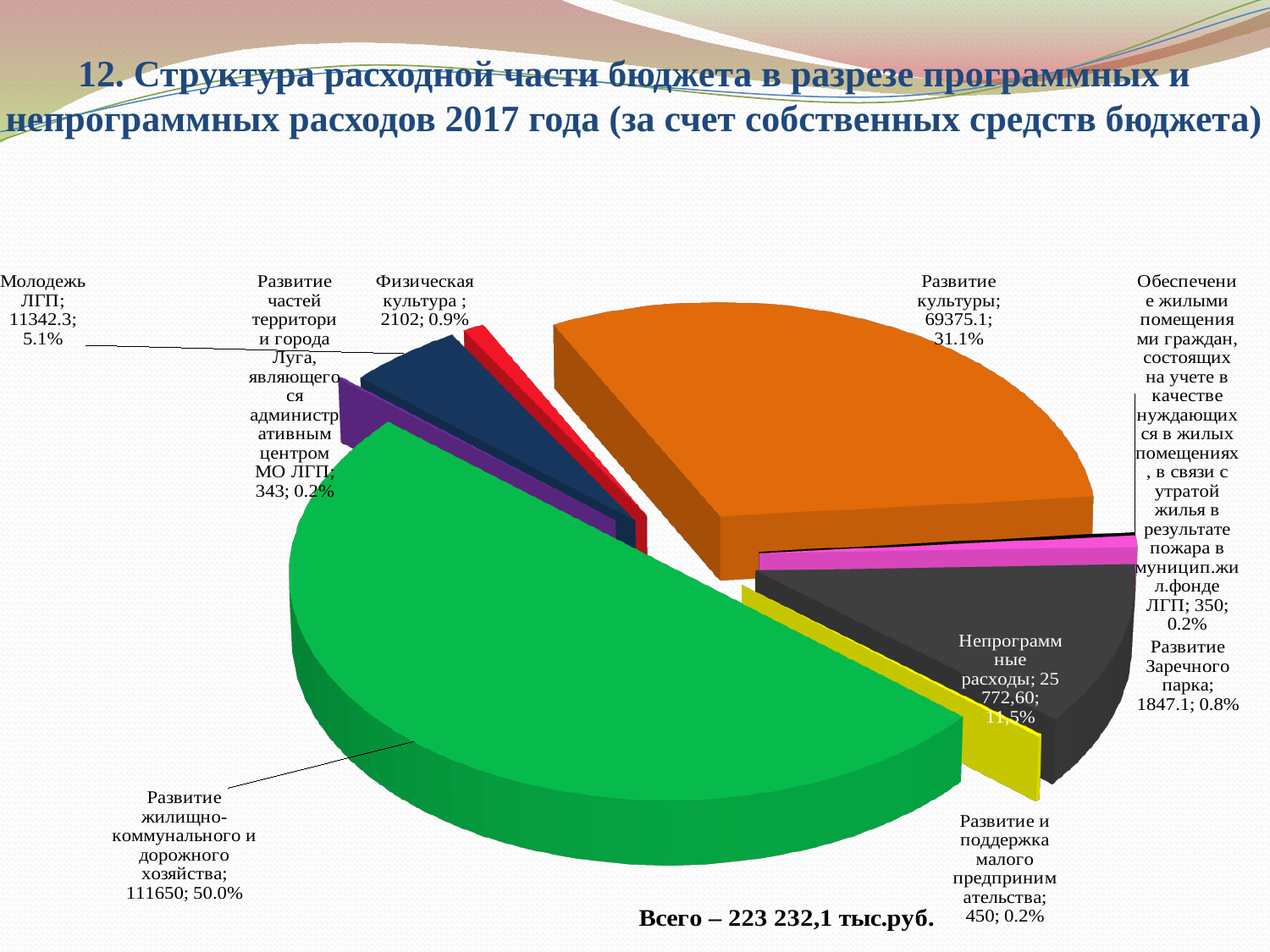
What is the value shown for "Развитие и поддержка малого предпринимательства"? 450; 0.2% What percentage is shown for "Непрограммные расходы"? 11,5% Which category has the largest slice of the pie? Развитие жилищно-коммунального и дорожного хозяйства What type of chart is shown on the slide? pie chart What is the difference in percentage share between "Развитие жилищно-коммунального и дорожного хозяйства" and "Развитие культуры"? 18.9% What is the value shown for "Молодежь ЛГП"? 11342.3; 5.1% How many slices does the pie chart have? 9 Which is larger: "Развитие культуры" or "Непрограммные расходы"? Развитие культуры What is the difference in value between "Физическая культура" and "Развитие Заречного парка"? 254.9 What total is stated below the chart? 223 232,1 тыс.руб. What is the value shown for "Развитие культуры"? 69375.1; 31.1% What share of the pie does "Развитие жилищно-коммунального и дорожного хозяйства" take? 50.0%